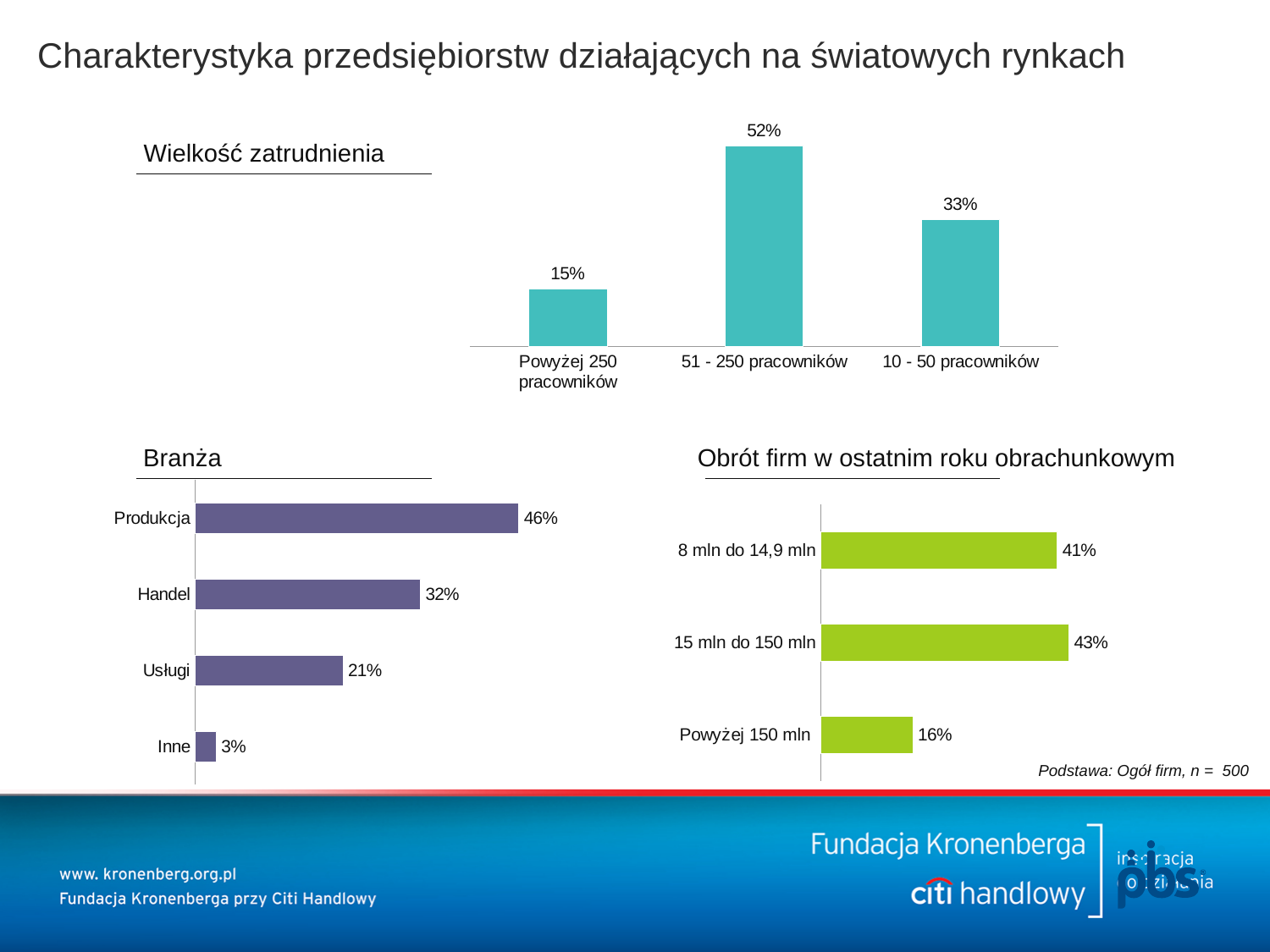
In the 'Wielkość zatrudnienia' chart, what is the difference between '51 - 250 pracowników' and '10 - 50 pracowników'? 19% In the 'Branża' chart, what is the value for 'Handel'? 32% In the 'Obrót firm w ostatnim roku obrachunkowym' chart, what is the value for 'Powyżej 150 mln'? 16% In the 'Wielkość zatrudnienia' chart, how many categories are shown? 3 In the 'Obrót firm w ostatnim roku obrachunkowym' chart, what is the difference between '15 mln do 150 mln' and '8 mln do 14,9 mln'? 2% What colour are the bars in the 'Branża' chart? Purple What kind of chart is the 'Obrót firm w ostatnim roku obrachunkowym' chart? Bar chart In the 'Branża' chart, which category has the highest value? Produkcja In the 'Wielkość zatrudnienia' chart, what is the value for '51 - 250 pracowników'? 52% In the 'Wielkość zatrudnienia' chart, which category has the lowest value? Powyżej 250 pracowników In the 'Branża' chart, which is larger, 'Usługi' or 'Inne'? Usługi In the 'Branża' chart, how many categories are shown? 4